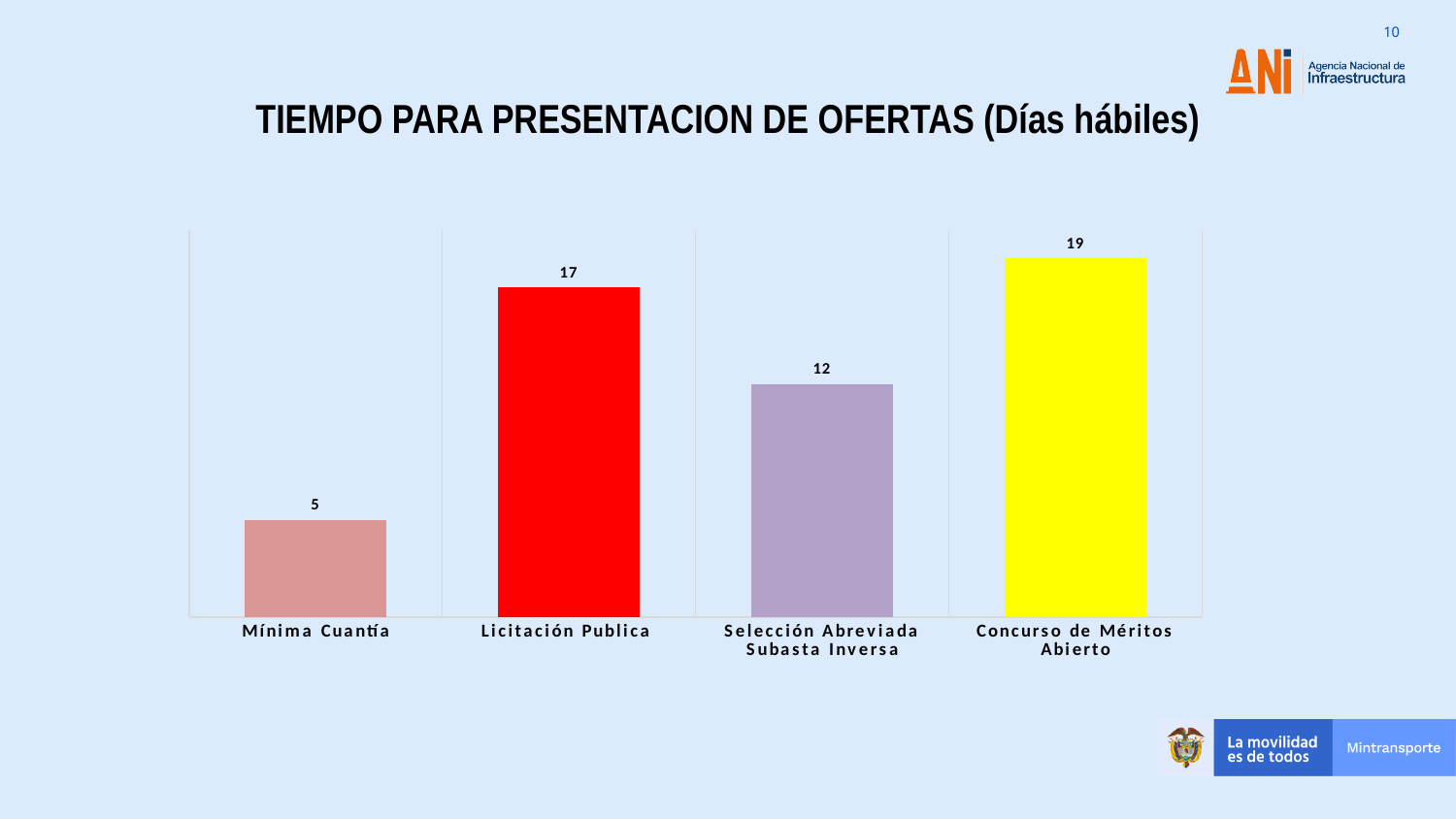
What is the value for Concurso de Méritos Abierto? 19 What is the difference between the values for Licitación Publica and Selección Abreviada Subasta Inversa? 5 What is the value for Licitación Publica? 17 Which is larger, the value for Licitación Publica or the value for Selección Abreviada Subasta Inversa? Licitación Publica What is the value for Selección Abreviada Subasta Inversa? 12 Which category has the highest value? Concurso de Méritos Abierto What is the difference between the values for Concurso de Méritos Abierto and Mínima Cuantía? 14 How many categories are shown in the chart? 4 Which category has the lowest value? Mínima Cuantía What is the value for Mínima Cuantía? 5 What kind of chart is shown on the slide? Bar chart What is the title of the chart? TIEMPO PARA PRESENTACION DE OFERTAS (Días hábiles)